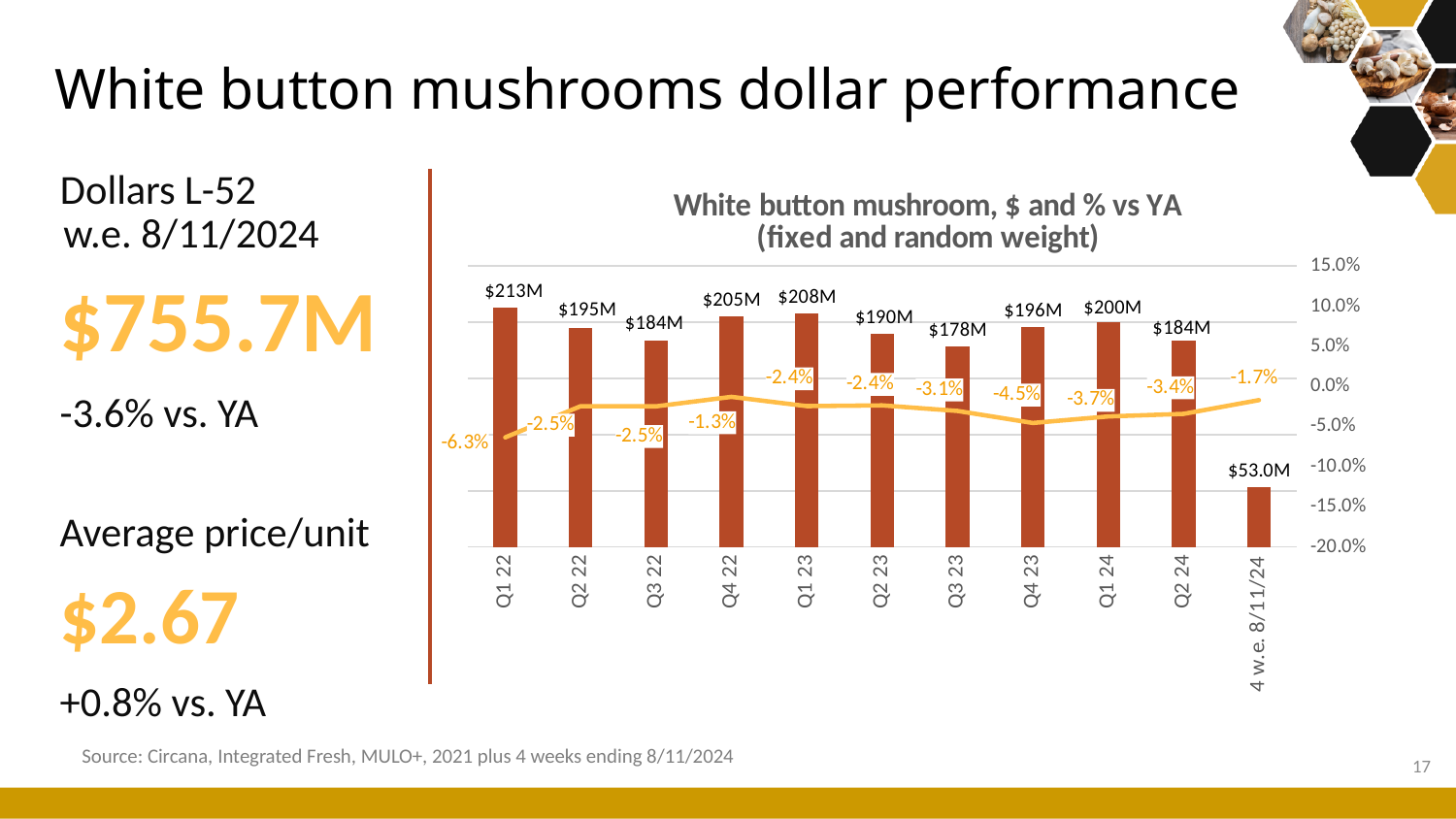
How many periods are shown on the x axis? 11 What is the title of the chart? White button mushroom, $ and % vs YA (fixed and random weight) Which has the larger dollar value, Q4 22 or Q1 23? Q1 23 What is the dollar value shown for Q1 22? $213M What is the % vs YA value shown for Q4 23? -4.5% What kind of chart is this? Bar chart with a line Which period has the lowest dollar value? 4 w.e. 8/11/24 Which period has the lowest % vs YA value on the line? Q1 22 What is the dollar value shown for the 4 w.e. 8/11/24 bar? $53.0M What is the difference in dollar value between Q1 22 and Q2 22? $18M Which period has the highest dollar value? Q1 22 Which period has the highest % vs YA value on the line? Q4 22